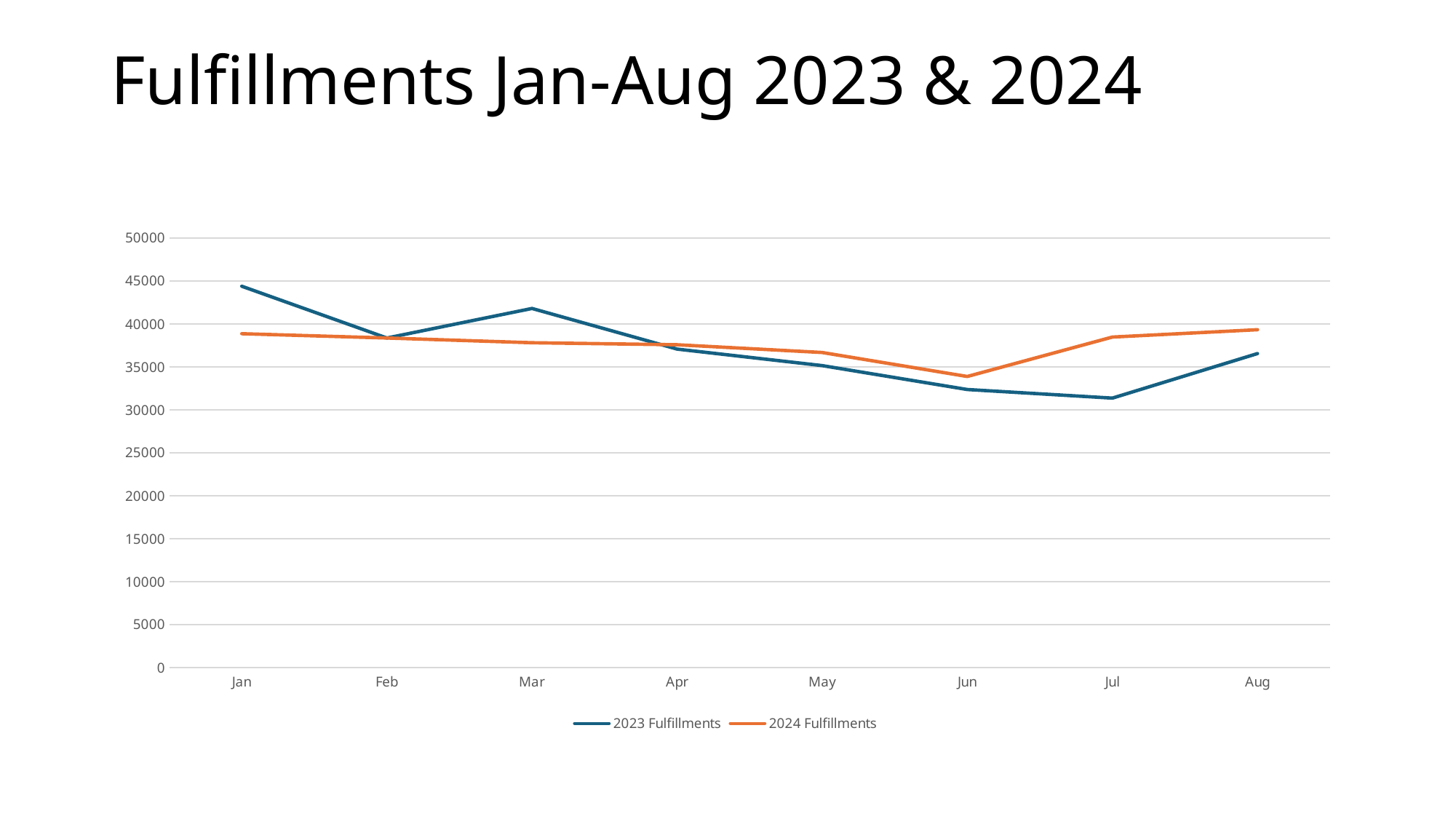
Is the 2023 Fulfillments value for Jan greater or less than 40000? greater Is the 2023 Fulfillments value for Jul greater or less than 35000? less In which month is the 2023 Fulfillments value highest? Jan In which month is the 2023 Fulfillments value lowest? Jul In Jul, which series has the larger value, 2023 Fulfillments or 2024 Fulfillments? 2024 Fulfillments What kind of chart is shown on the slide? line chart In which month is the 2024 Fulfillments value lowest? Jun Does the 2024 Fulfillments line rise or fall from Jan to Jun? fall Is the 2024 Fulfillments value for Aug greater or less than 40000? less How many series does the legend list? 2 How many months are plotted along the x axis? 8 In Jan, which series has the larger value, 2023 Fulfillments or 2024 Fulfillments? 2023 Fulfillments